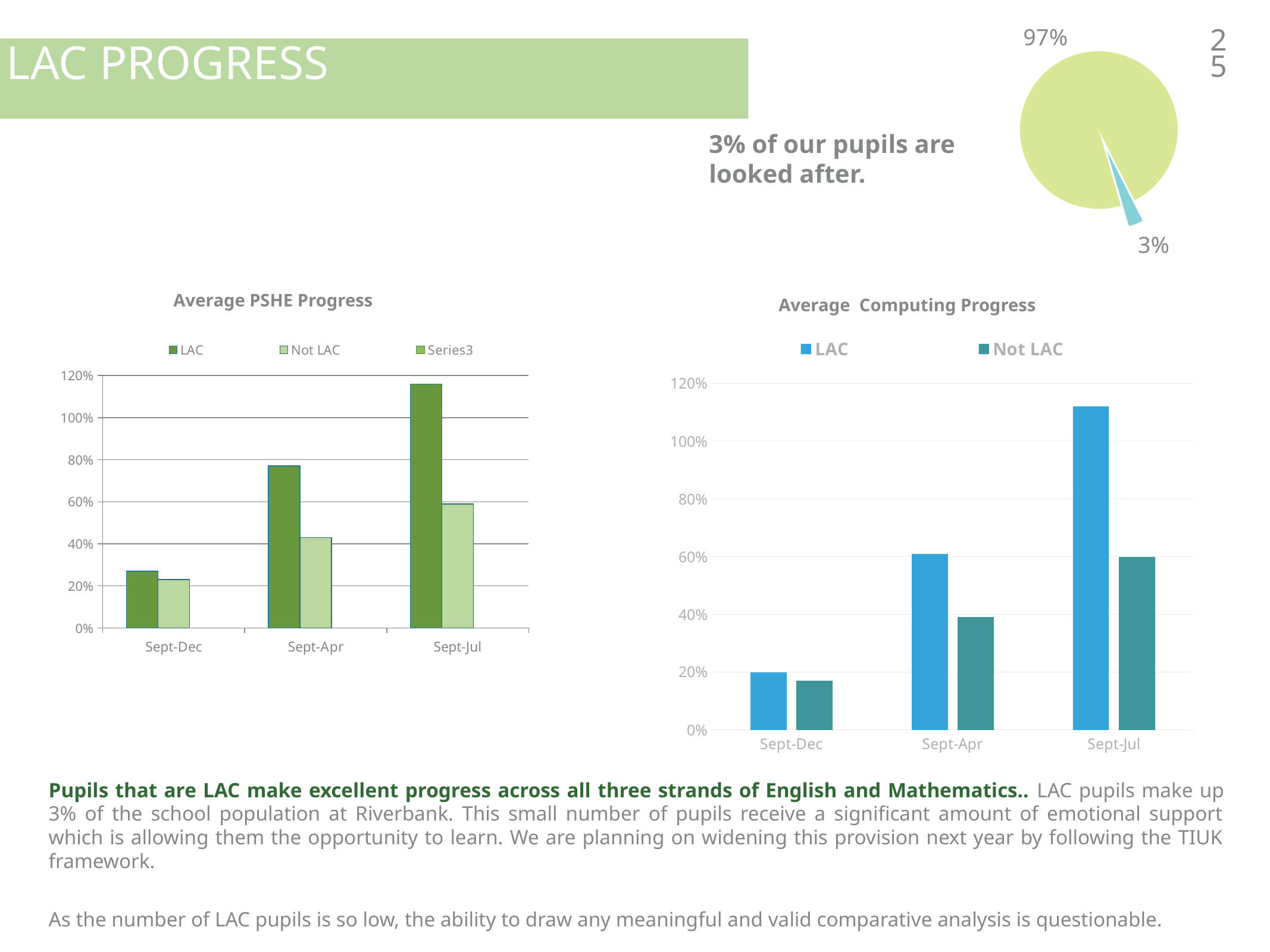
In the Average PSHE Progress chart, how many categories are on the x axis? 3 In the Average Computing Progress chart, how many series does the legend list? 2 In the Average PSHE Progress chart, how many series does the legend list? 3 In the Average PSHE Progress chart, which category has the highest LAC value? Sept-Jul In the Average Computing Progress chart, which is larger for Sept-Jul, LAC or Not LAC? LAC In the pie chart at the top right, what is the value of the smaller slice? 3% What kind of chart is the Average Computing Progress chart? bar chart In the Average PSHE Progress chart, do the LAC values rise or fall from Sept-Dec to Sept-Jul? rise How many slices does the pie chart at the top right have? 2 In the Average PSHE Progress chart, is the LAC value for Sept-Jul greater or less than 100%? greater In the pie chart at the top right, what is the value of the larger slice? 97%